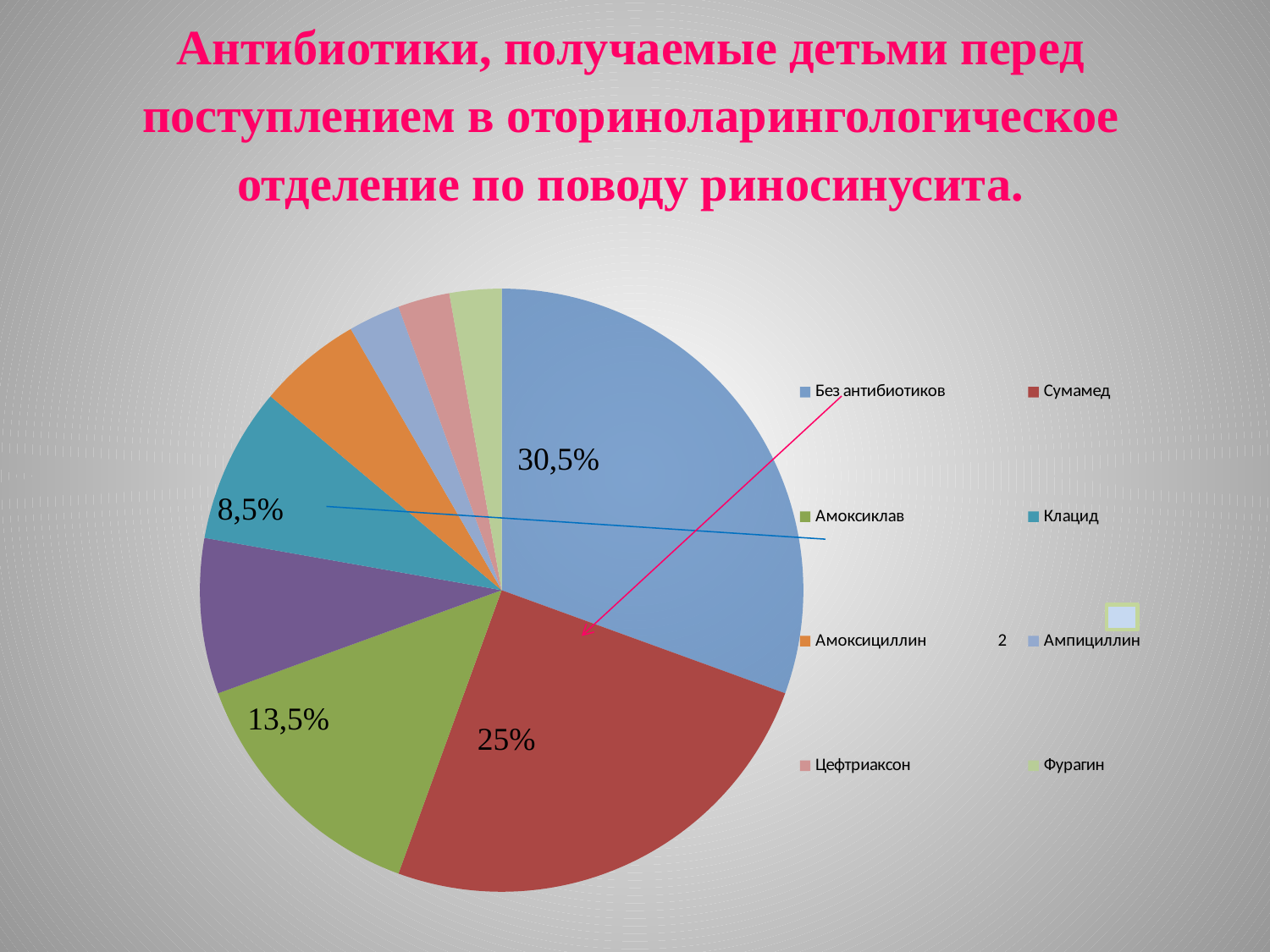
Which category has the largest slice of the pie? Без антибиотиков Which slice is larger, Сумамед or Амоксиклав? Сумамед What is the difference between the shares for Без антибиотиков and Сумамед? 5,5% What share of the pie is labelled for Сумамед? 25% What share of the pie is labelled for Без антибиотиков? 30,5% What share of the pie is labelled for Амоксиклав? 13,5% How many slices does the pie chart have? 9 Which slice is larger, Клацид or Амоксиклав? Амоксиклав What colour is the slice for Сумамед in the legend? Red What kind of chart is shown on the slide? Pie chart What is the difference between the shares for Сумамед and Амоксиклав? 11,5% What share of the pie is labelled for Клацид? 8,5%